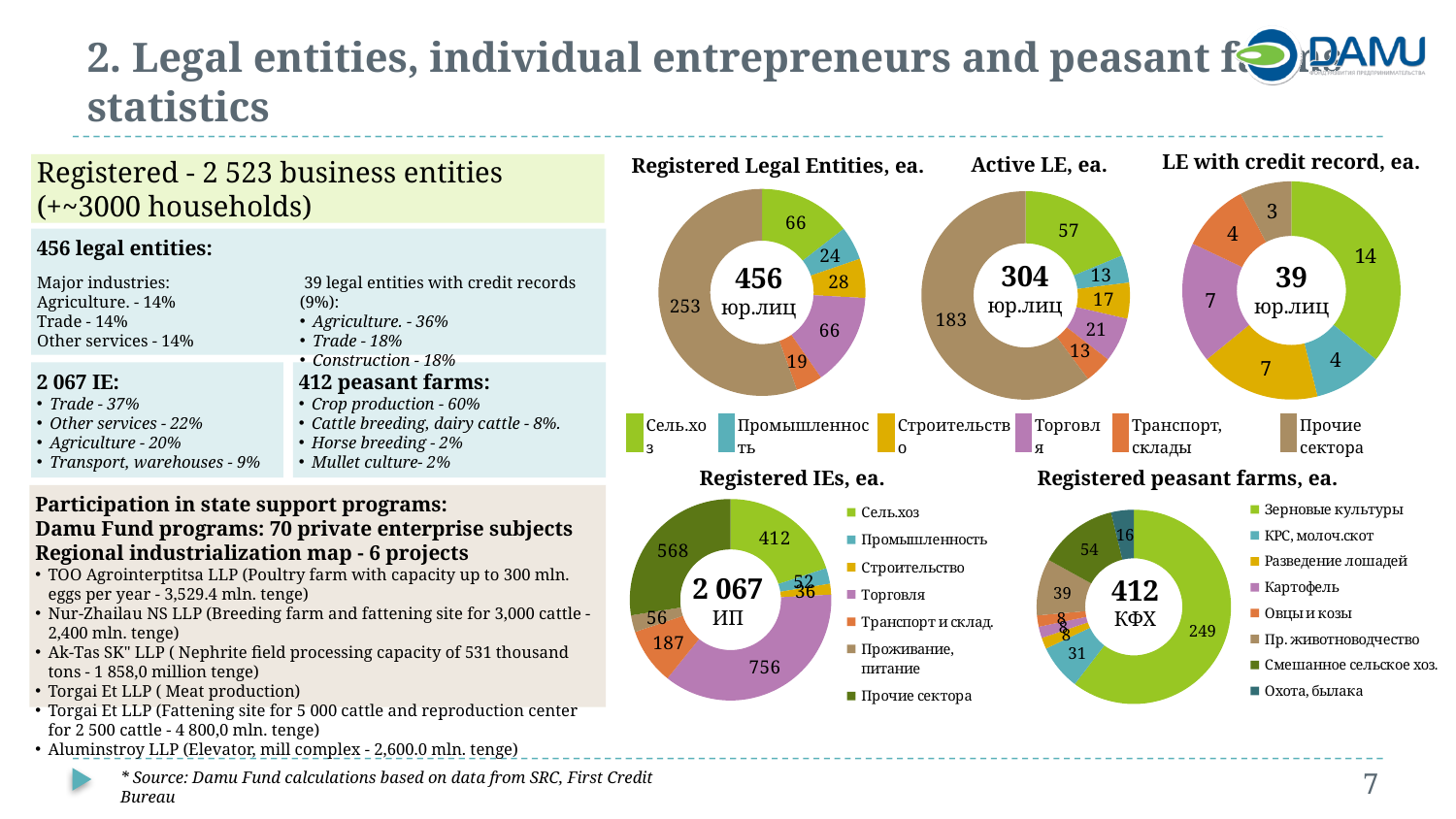
In the 'Registered Legal Entities, ea.' chart, what is the value for Прочие сектора? 253 In the 'Registered IEs, ea.' chart, what is the value for Торговля? 756 In the 'Active LE, ea.' chart, which sector has the largest segment? Прочие сектора In the 'Registered IEs, ea.' chart, which is larger: Сельхоз or Прочие сектора? Прочие сектора In the 'LE with credit record, ea.' chart, which sector has the smallest segment? Прочие сектора In the 'Registered Legal Entities, ea.' chart, what is the difference between the Сельхоз value and the Транспорт, склады value? 47 How many entries does the legend of the 'Registered IEs, ea.' chart list? 7 In the 'LE with credit record, ea.' chart, what is the difference between the Сельхоз value and the Прочие сектора value? 11 What kind of chart is the 'Registered peasant farms, ea.' chart? Pie (donut) chart What total number is shown in the centre of the 'Registered Legal Entities, ea.' chart? 456 In the 'Active LE, ea.' chart, what is the value for Сельхоз? 57 In the 'Registered peasant farms, ea.' chart, what is the value for Зерновые культуры? 249